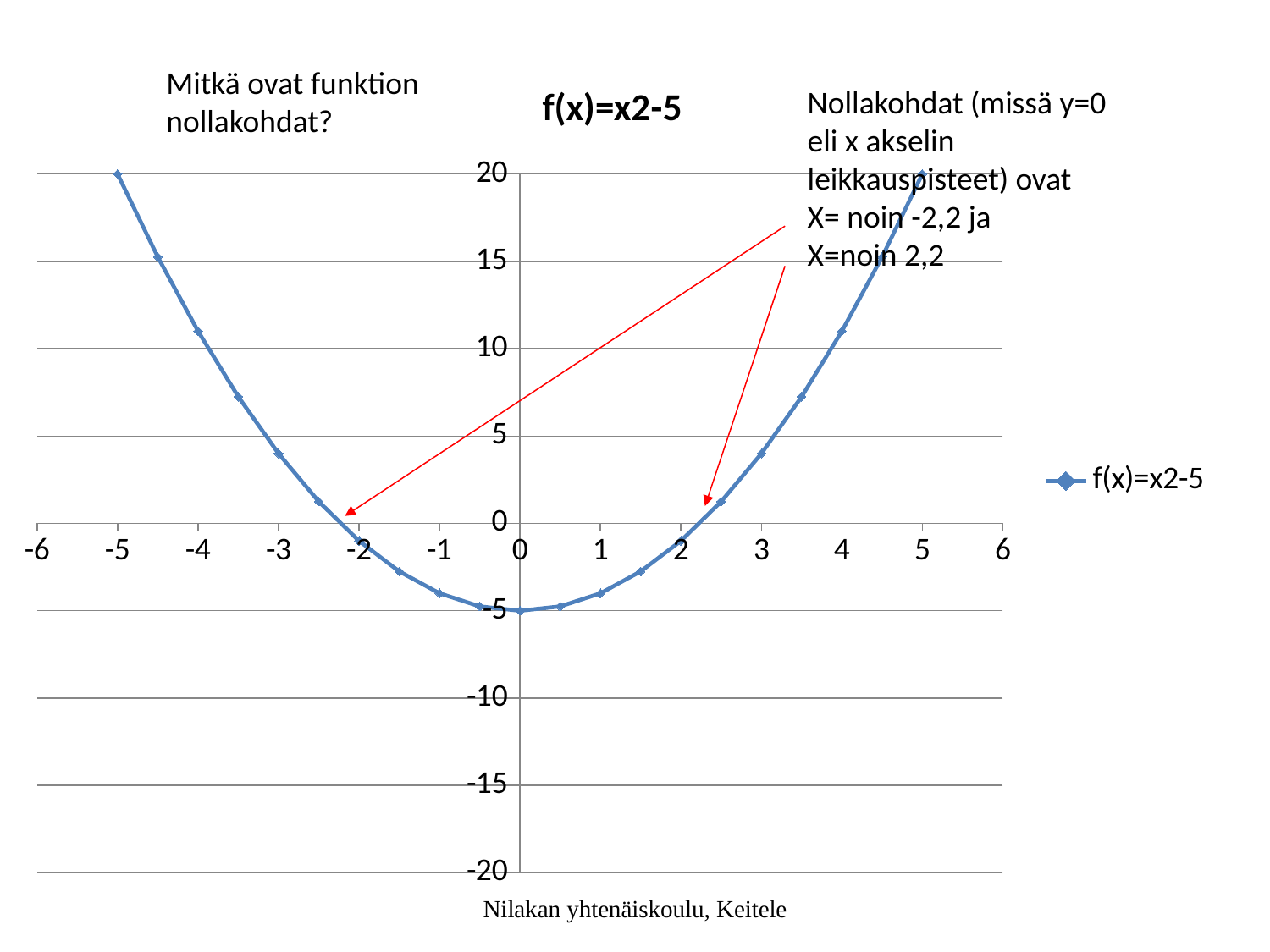
Is the value of f(x) at x = 4 greater or less than 15? less How many series does the legend list? 1 What is the value of f(x) at x = 0? -5 Which is larger, the value of f(x) at x = -5 or at x = 0? x = -5 Is the value of f(x) at x = 2 greater or less than 0? less What is the value of f(x) at x = -5? 20 Do the plotted values rise or fall as x increases from 0 to 5? rise What is the title of the chart? f(x)=x2-5 Is the value of f(x) at x = 3 greater or less than 5? less What kind of chart is shown on the slide? line chart At which x value does the plotted function reach its lowest value? 0 What is the value of f(x) at x = 5? 20